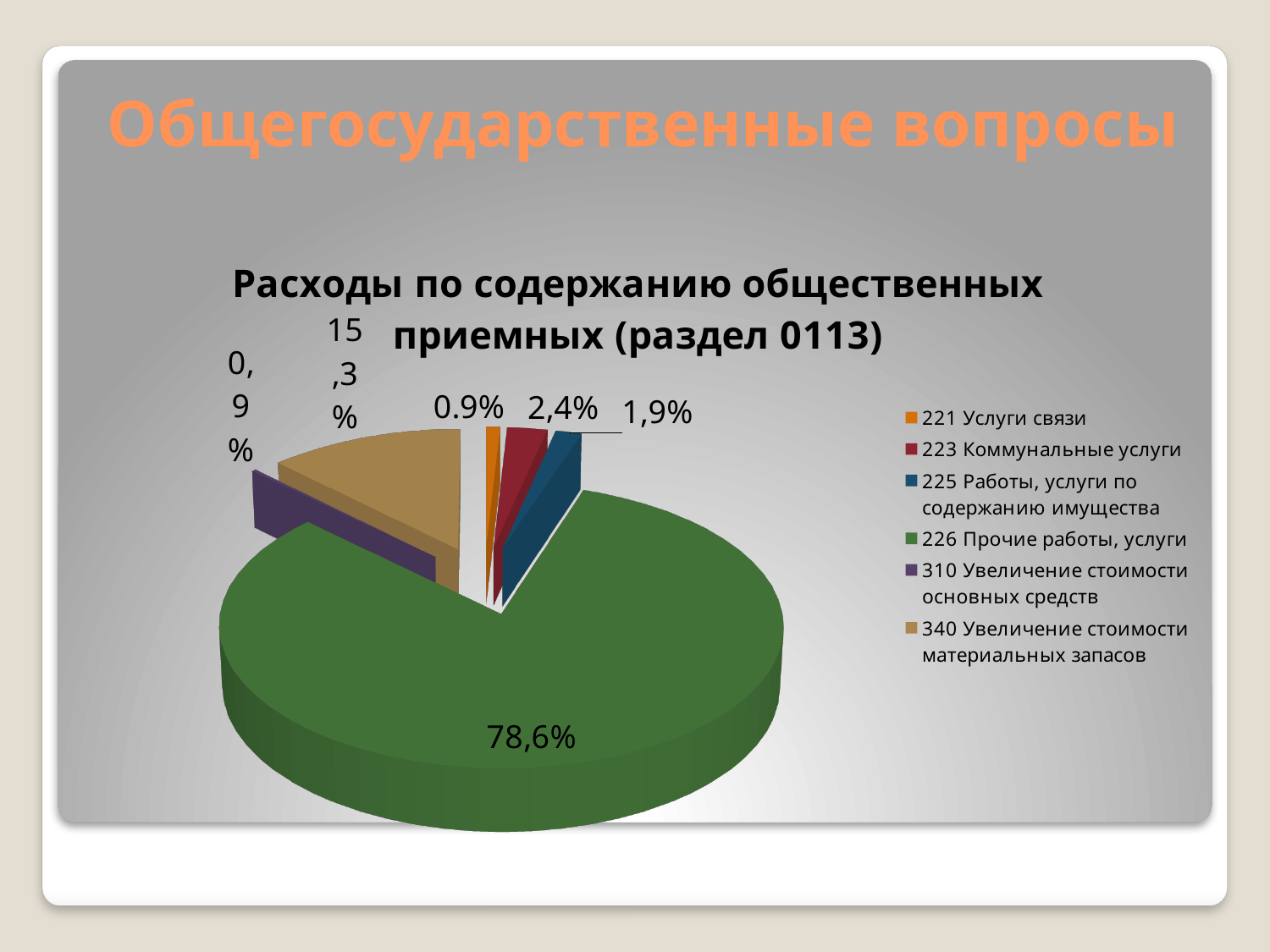
What is the value shown for "223 Коммунальные услуги"? 2,4% What is the value shown for "225 Работы, услуги по содержанию имущества"? 1,9% What is the difference between the shares of "226 Прочие работы, услуги" and "340 Увеличение стоимости материальных запасов"? 63,3% What share of the pie does "226 Прочие работы, услуги" take? 78,6% What is the value shown for "221 Услуги связи"? 0.9% Which is larger: the share of "223 Коммунальные услуги" or "225 Работы, услуги по содержанию имущества"? 223 Коммунальные услуги What is the title of the chart? Расходы по содержанию общественных приемных (раздел 0113) What kind of chart is shown on the slide? pie chart What colour is the slice for "226 Прочие работы, услуги"? green What is the value shown for "340 Увеличение стоимости материальных запасов"? 15,3% How many categories does the legend list? 6 Which category has the largest slice of the pie? 226 Прочие работы, услуги